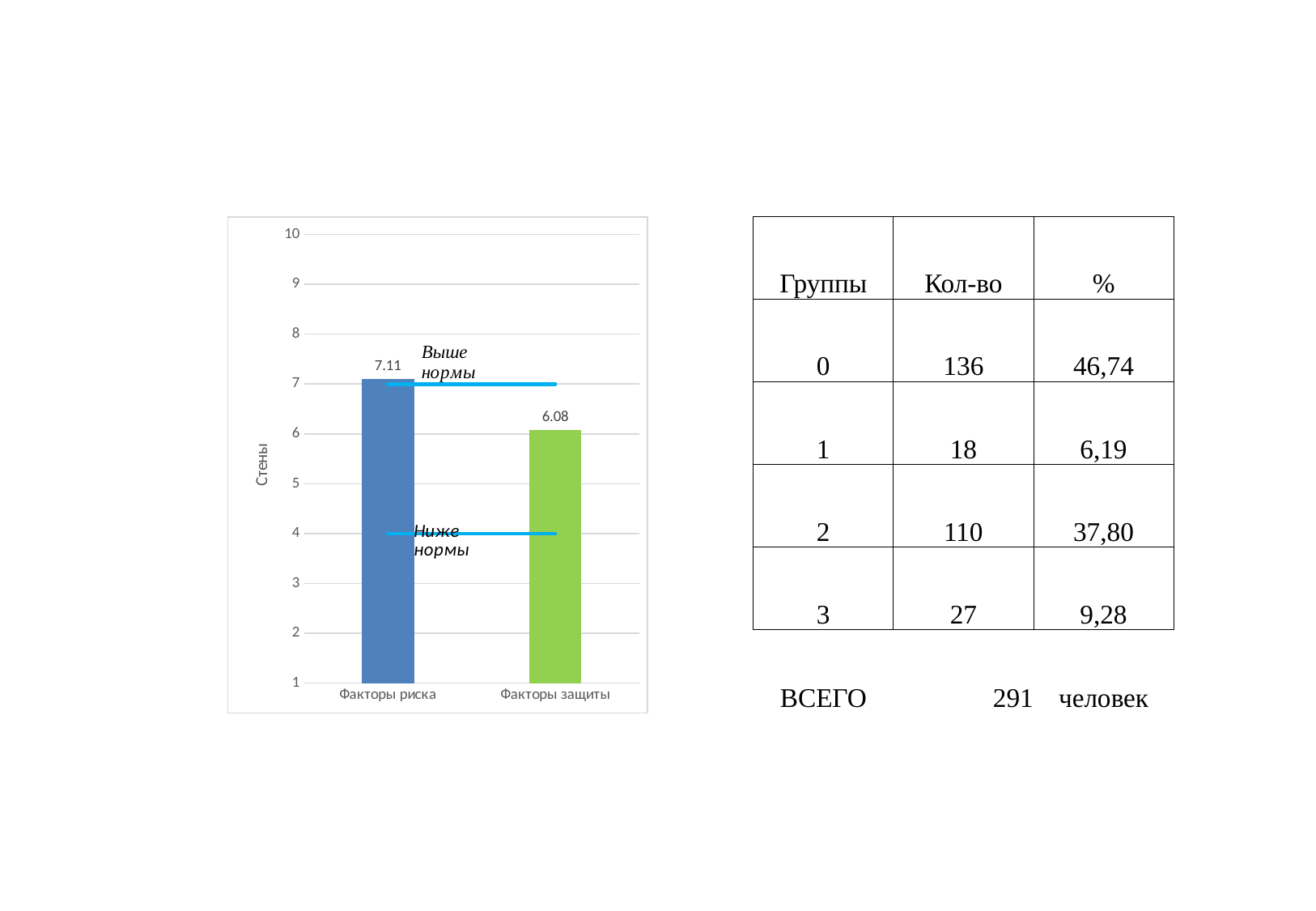
What is the label of the vertical axis of the chart? Стены Is the value for Факторы защиты greater or less than 7? less How many categories are shown on the x axis of the chart? 2 What is the value for Факторы риска? 7.11 Is the value for Факторы риска greater or less than 7? greater Which category has the highest value? Факторы риска What is the value for Факторы защиты? 6.08 What is the difference between the values for Факторы риска and Факторы защиты? 1.03 Which is larger, the value for Факторы риска or the value for Факторы защиты? Факторы риска What label is attached to the horizontal line drawn at the level of 7 on the chart? Выше нормы What kind of chart is shown on the slide? bar chart Which category has the lowest value? Факторы защиты